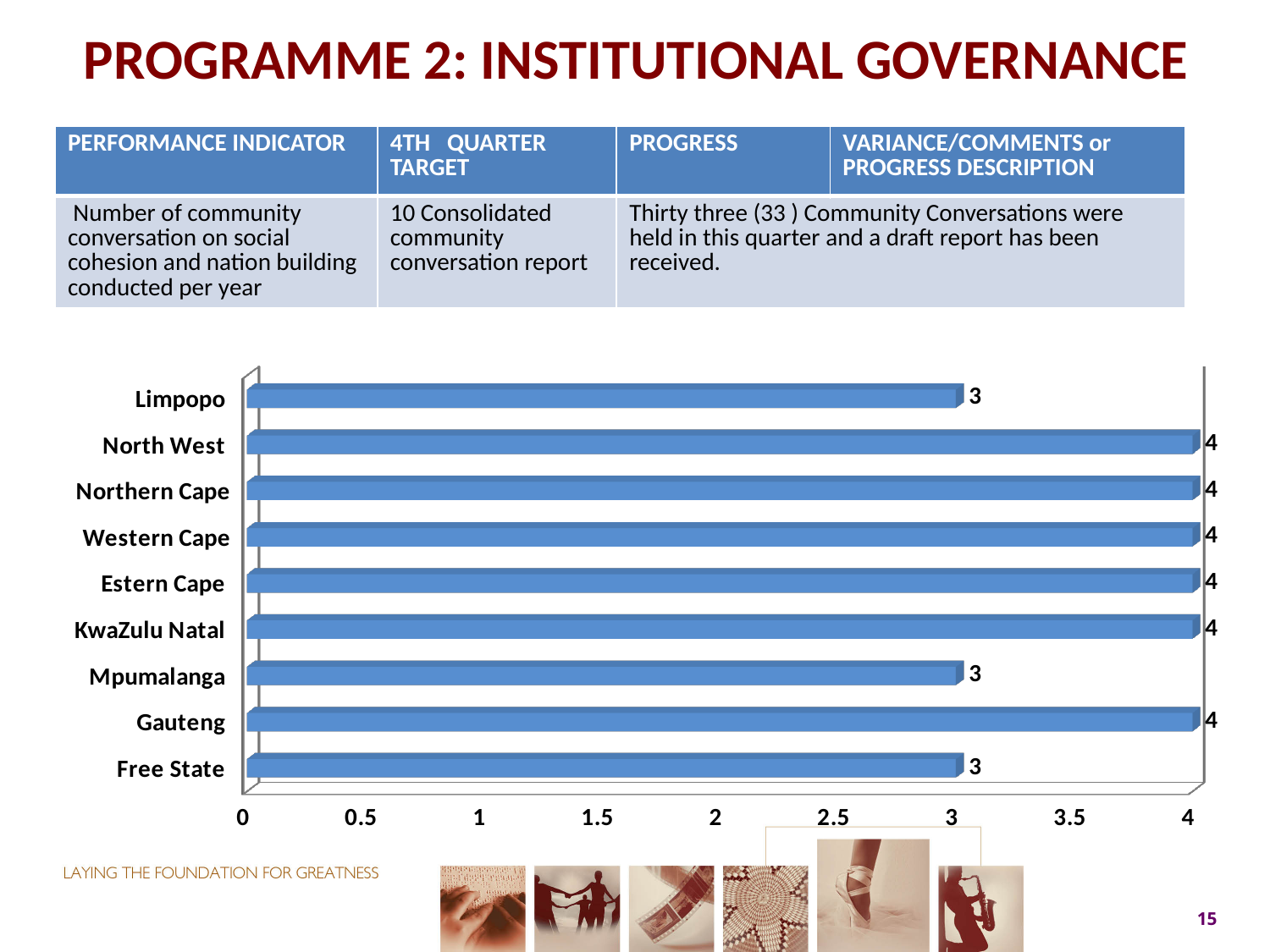
What is the value for KwaZulu Natal? 4 What is the value for Gauteng? 4 What is the value for Mpumalanga? 3 Which is larger, the value for Gauteng or the value for Free State? Gauteng Which is larger, the value for Mpumalanga or the value for Western Cape? Western Cape What is the value for Free State? 3 What is the difference between the values for North West and Limpopo? 1 What kind of chart is shown on the slide? bar chart How many provinces have a value of 4? 6 What is the value for Limpopo? 3 How many provinces are shown on the chart? 9 Is the value for Limpopo greater or less than 3.5? less